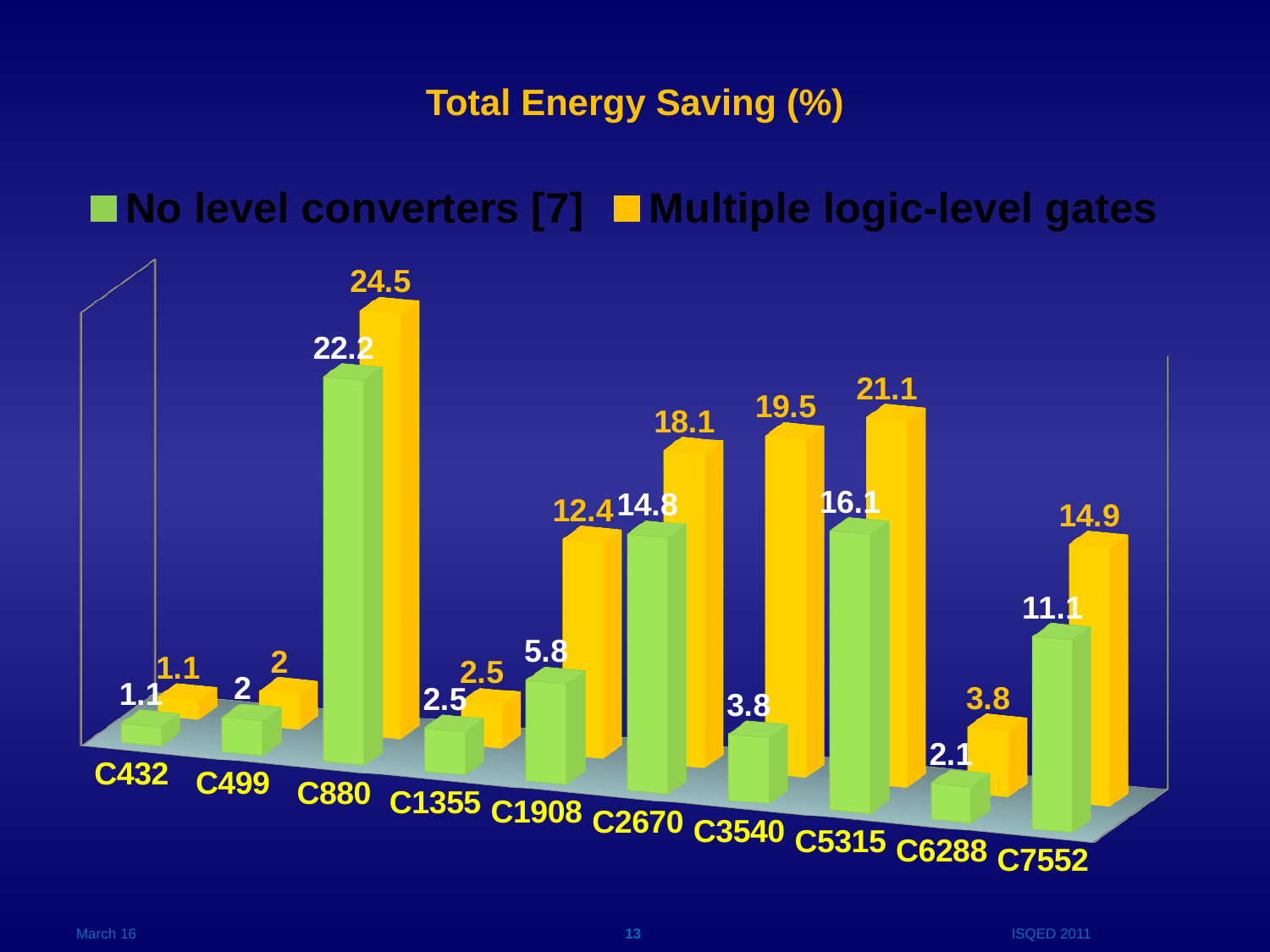
What is the title of the chart? Total Energy Saving (%) Which category has the lowest value in the Multiple logic-level gates series? C432 What is the difference between the Multiple logic-level gates value and the No level converters [7] value for C3540? 15.7 What is the value for C3540 in the No level converters [7] series? 3.8 What kind of chart is shown on the slide? Bar chart Which is larger for C7552: the No level converters [7] value or the Multiple logic-level gates value? Multiple logic-level gates How many categories (circuits) are shown on the x axis? 10 What is the value for C880 in the Multiple logic-level gates series? 24.5 What is the value for C5315 in the Multiple logic-level gates series? 21.1 How many series does the legend list? 2 Which category has the highest value in the No level converters [7] series? C880 What is the difference between the two series' values for C1908? 6.6